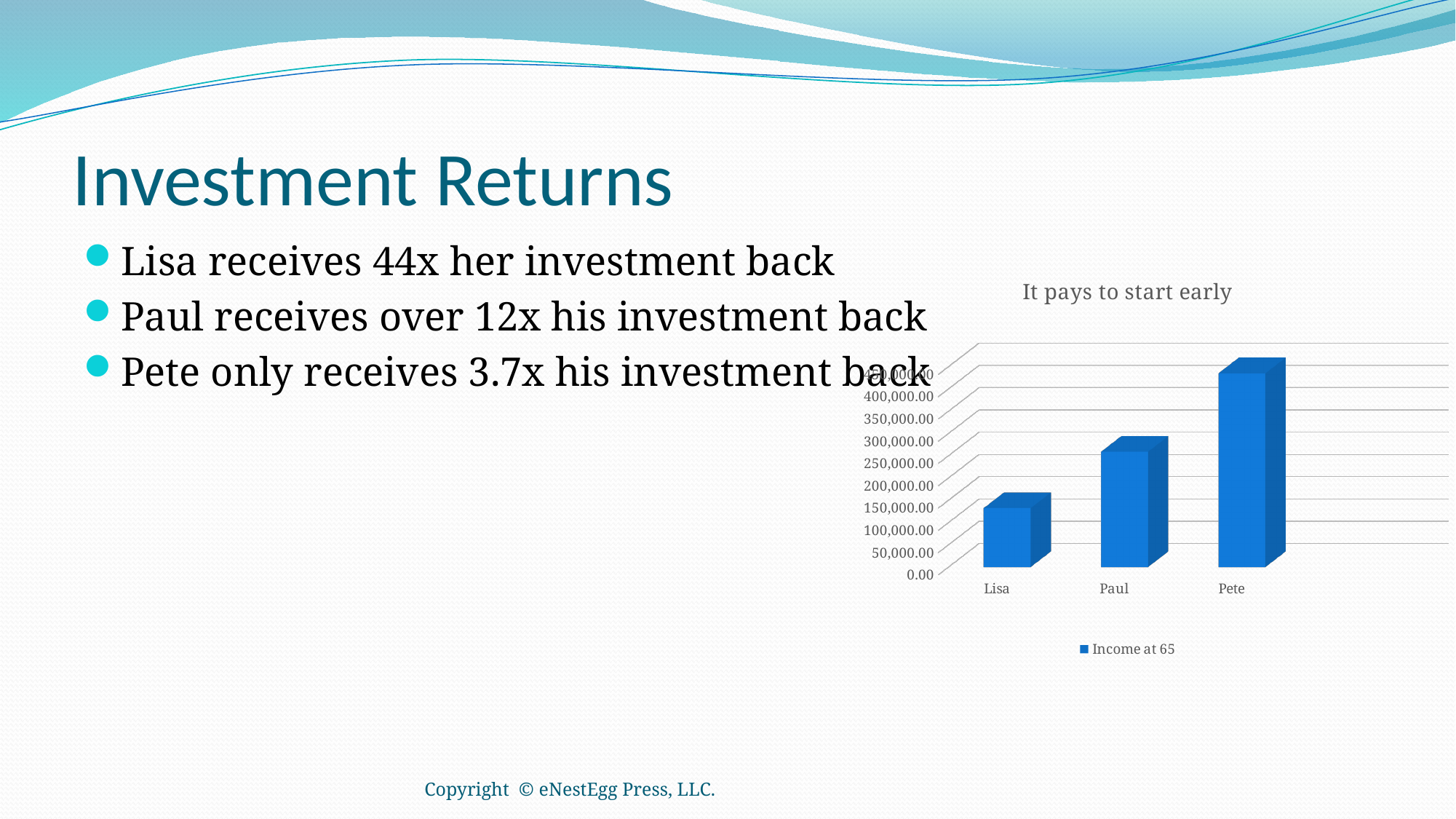
Is the Income at 65 value for Pete greater or less than 350,000.00? greater How many categories are shown on the x axis of the chart? 3 Which is larger, the Income at 65 for Paul or for Lisa? Paul Is the Income at 65 value for Paul greater or less than 200,000.00? greater What is the title of the chart? It pays to start early Which person has the highest Income at 65 in the chart? Pete What series does the chart legend list? Income at 65 Which person has the lowest Income at 65 in the chart? Lisa What kind of chart is shown on the slide? bar chart Do the bar values rise or fall moving from Lisa to Pete along the x axis? rise How many series does the legend list? 1 Is the Income at 65 value for Lisa greater or less than 200,000.00? less